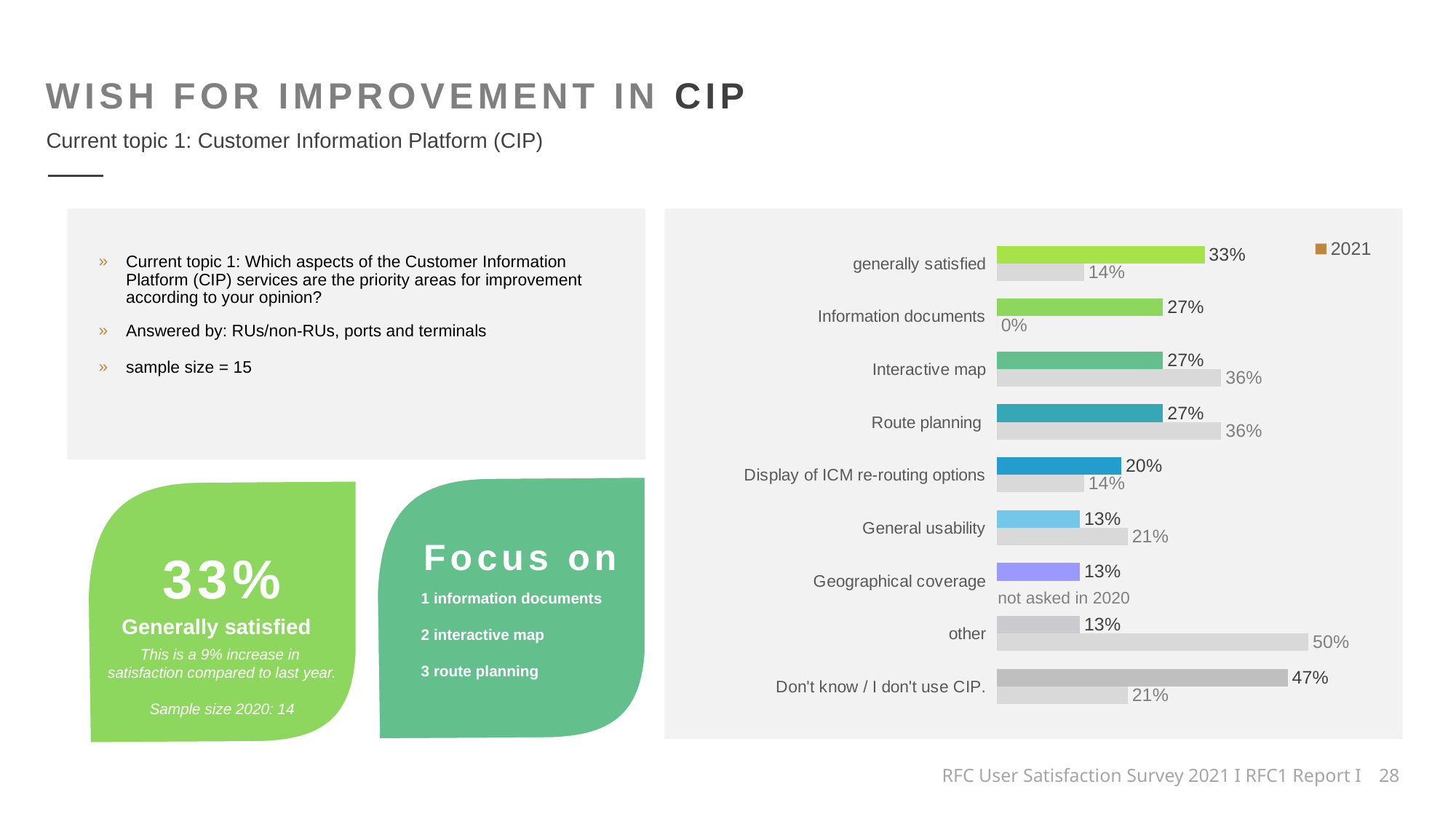
How many categories are shown in the chart? 9 What type of chart is shown on the slide? Bar chart What is the 2021 value for "generally satisfied"? 33% What series does the chart legend list? 2021 Which is larger for "General usability": the 2021 value or the 2020 value? 2020 value Which category has the highest 2021 value? Don't know / I don't use CIP. What is the 2020 value (grey bar) for "other"? 50% Which category is labelled "not asked in 2020" instead of a 2020 value? Geographical coverage What is the 2020 value (grey bar) for "Information documents"? 0% What is the difference between the 2021 and 2020 values for "Route planning"? 9% What is the 2021 value for "Display of ICM re-routing options"? 20% Which category has the lowest 2020 value (grey bar)? Information documents